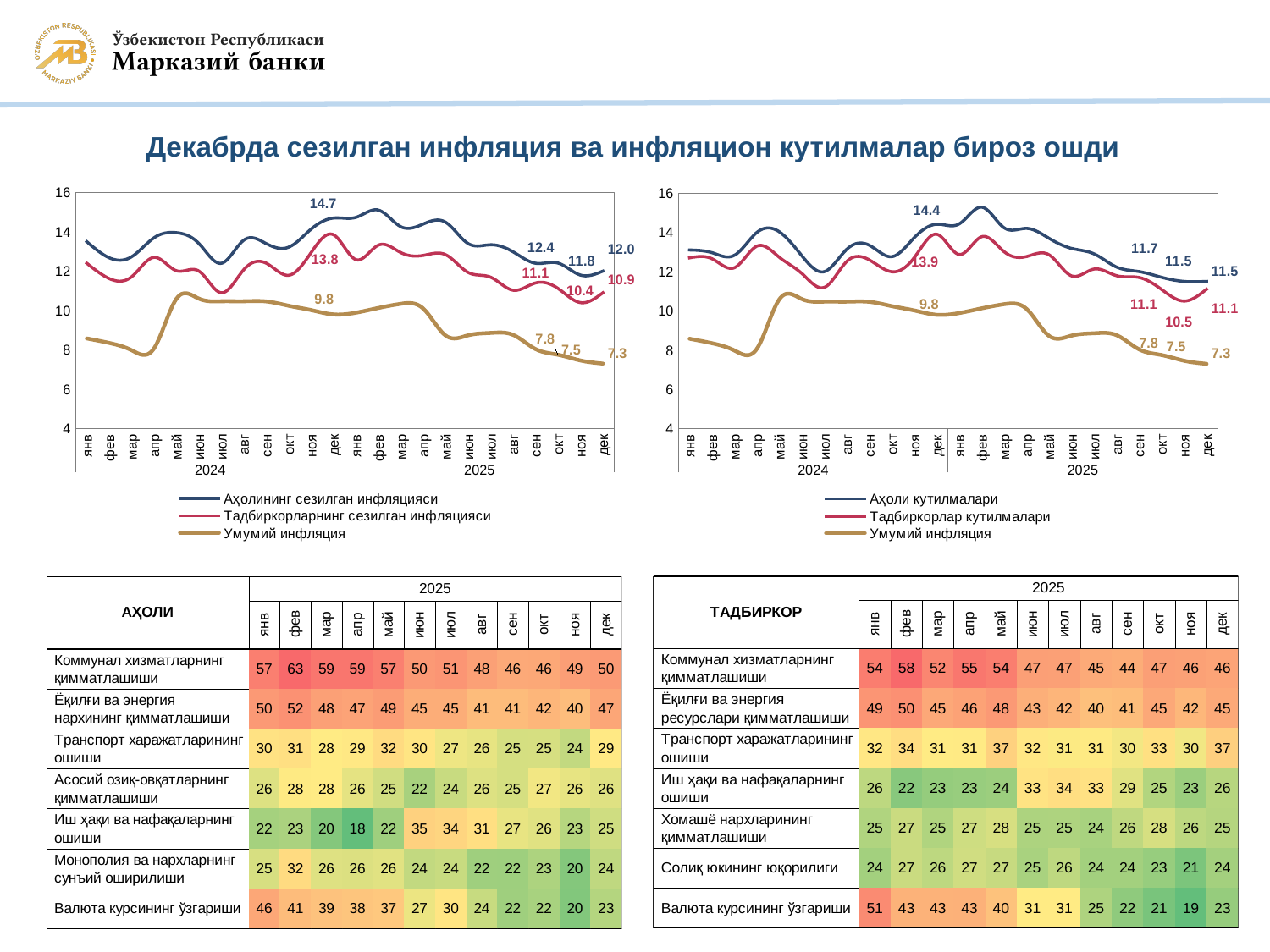
In the left chart, what is the difference between Аҳолининг сезилган инфляцияси and Тадбиркорларнинг сезилган инфляцияси in December 2025? 1.1 How many series does the legend of the right chart list? 3 In the right chart, what is the value of Тадбиркорлар кутилмалари in December 2025? 11.1 In the left chart, which series has the highest value in December 2025? Аҳолининг сезилган инфляцияси In the right chart, what is the difference between Аҳоли кутилмалари and Тадбиркорлар кутилмалари in December 2024? 0.5 In the left chart, is the value of Умумий инфляция in January 2024 greater or less than 10? less In the right chart, what is the value of Аҳоли кутилмалари in December 2024? 14.4 What type of chart is the left chart on the slide? Line chart In the right chart, which is larger in December 2025: Аҳоли кутилмалари or Тадбиркорлар кутилмалари? Аҳоли кутилмалари In the left chart, what is the value of Умумий инфляция in December 2025? 7.3 In the left chart, what is the value of Аҳолининг сезилган инфляцияси in December 2024? 14.7 In the left chart, does Умумий инфляция rise or fall from December 2024 to December 2025? Fall